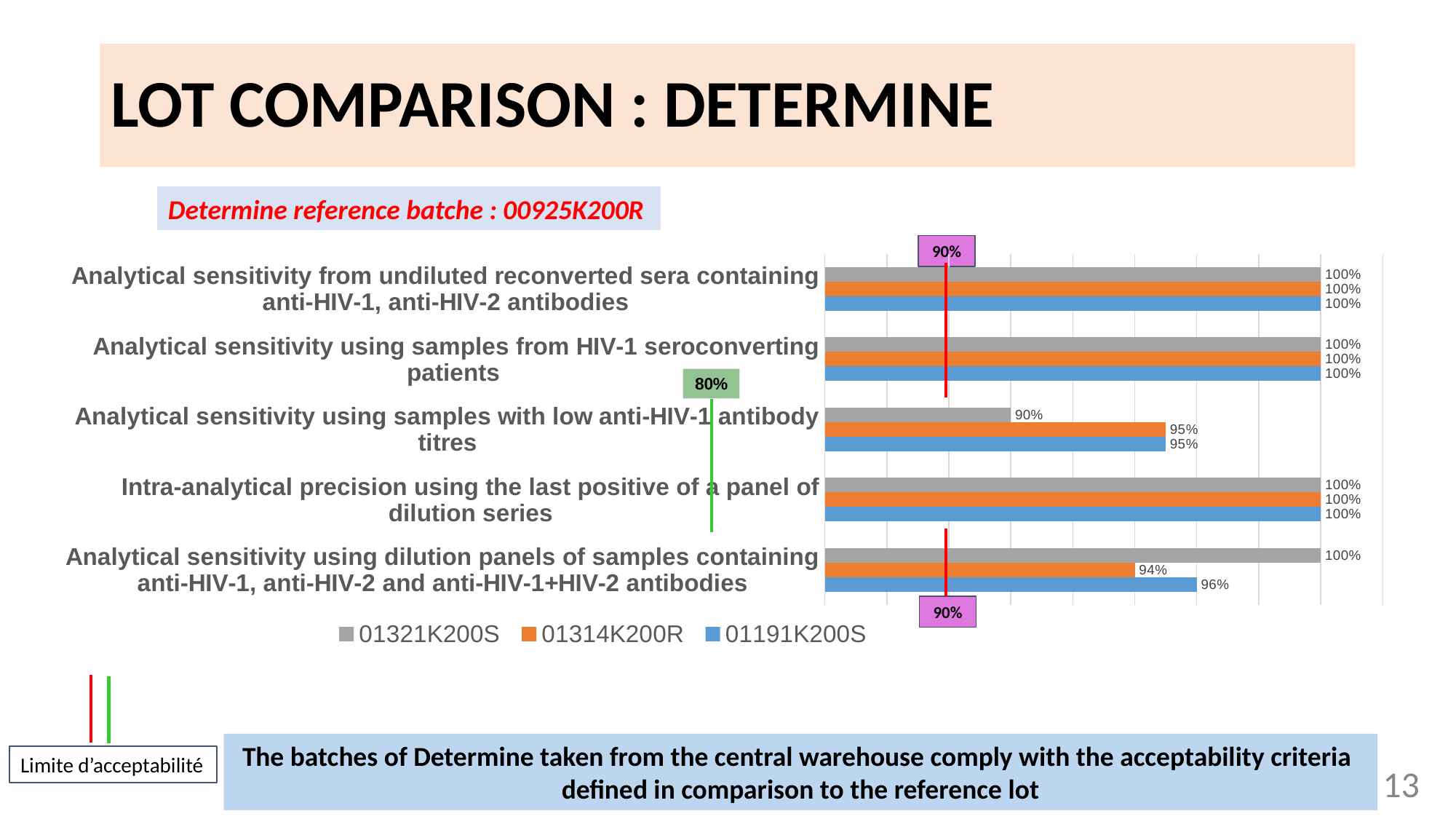
What is the value for 01314K200R in the category 'Analytical sensitivity using dilution panels of samples containing anti-HIV-1, anti-HIV-2 and anti-HIV-1+HIV-2 antibodies'? 94% In the category 'Analytical sensitivity using dilution panels of samples containing anti-HIV-1, anti-HIV-2 and anti-HIV-1+HIV-2 antibodies', which is larger: the value for 01314K200R or for 01191K200S? 01191K200S What is the value for 01321K200S in the category 'Intra-analytical precision using the last positive of a panel of dilution series'? 100% What is the value for 01314K200R in the category 'Analytical sensitivity using samples with low anti-HIV-1 antibody titres'? 95% What kind of chart is shown on the slide? bar chart How many series does the chart legend list? 3 What is the value for 01191K200S in the category 'Analytical sensitivity using dilution panels of samples containing anti-HIV-1, anti-HIV-2 and anti-HIV-1+HIV-2 antibodies'? 96% Which colour represents the series 01314K200R in the chart legend? orange How many categories are plotted on the chart? 5 What is the value for 01321K200S in the category 'Analytical sensitivity using samples with low anti-HIV-1 antibody titres'? 90% What is the difference between the 01321K200S and 01314K200R values in the category 'Analytical sensitivity using dilution panels of samples containing anti-HIV-1, anti-HIV-2 and anti-HIV-1+HIV-2 antibodies'? 6% Which series has the lowest value in the category 'Analytical sensitivity using samples with low anti-HIV-1 antibody titres'? 01321K200S